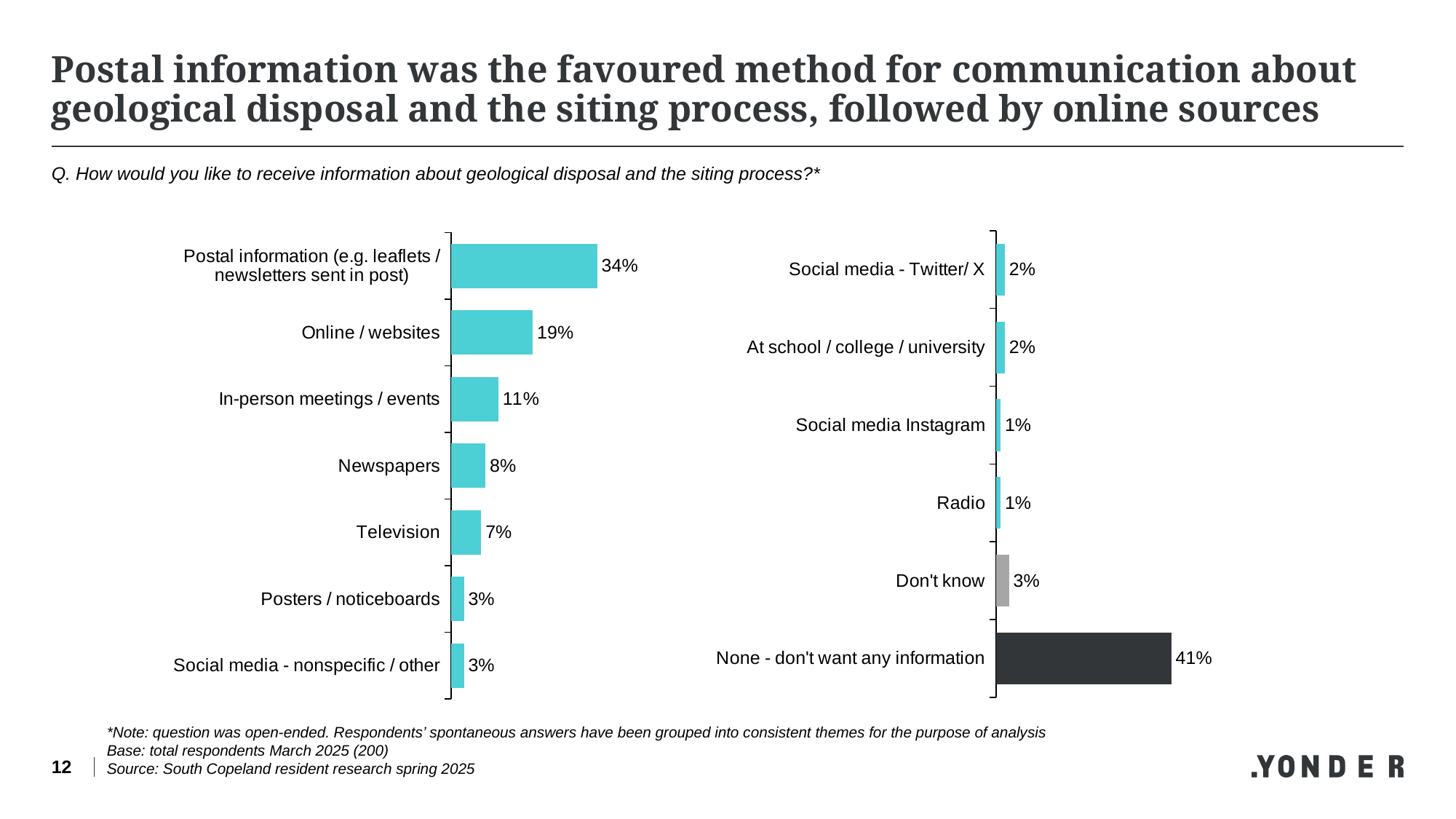
In the left chart, what percentage of respondents said they would like to receive information by postal information (e.g. leaflets / newsletters sent in post)? 34% How many categories are shown in the right chart? 6 In the left chart, which category has the lowest value? Posters / noticeboards and Social media - nonspecific / other (both 3%) In the left chart, what is the difference between the values for Postal information and Online / websites? 15 percentage points In the right chart, what is the difference between the values for None - don't want any information and Don't know? 38 percentage points In the right chart, what is the value for None - don't want any information? 41% In the left chart, which is larger, the value for Newspapers or the value for Television? Newspapers In the right chart, what is the value for Don't know? 3% How many categories are shown in the left chart? 7 What type of chart is used on this slide? Bar chart In the left chart, what is the value for Online / websites? 19% In the right chart, which category has the highest value? None - don't want any information